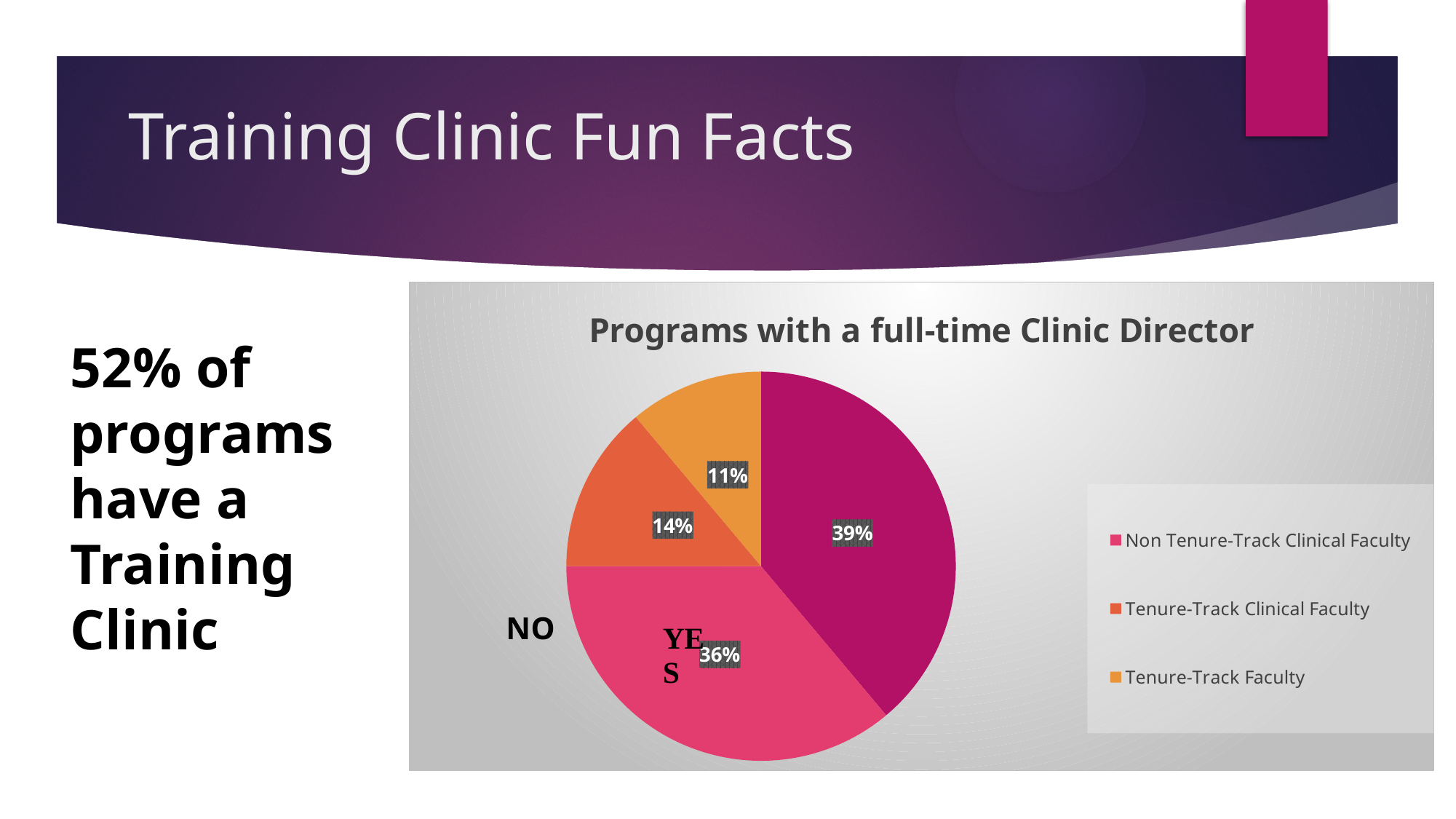
What percentage is shown for Non Tenure-Track Clinical Faculty? 36% How many entries does the chart legend list? 3 How many slices does the pie chart have? 4 What percentage is shown for Tenure-Track Faculty? 11% How many percentage points larger is the Non Tenure-Track Clinical Faculty slice than the Tenure-Track Clinical Faculty slice? 22 What percentage is shown for Tenure-Track Clinical Faculty? 14% How many percentage points larger is the Tenure-Track Clinical Faculty slice than the Tenure-Track Faculty slice? 3 Which legend category has the smallest slice of the pie? Tenure-Track Faculty What kind of chart is shown on the slide? pie chart What is the title of the chart? Programs with a full-time Clinic Director Which is larger: the Tenure-Track Clinical Faculty slice or the Tenure-Track Faculty slice? Tenure-Track Clinical Faculty What is the largest percentage label shown on the pie? 39%